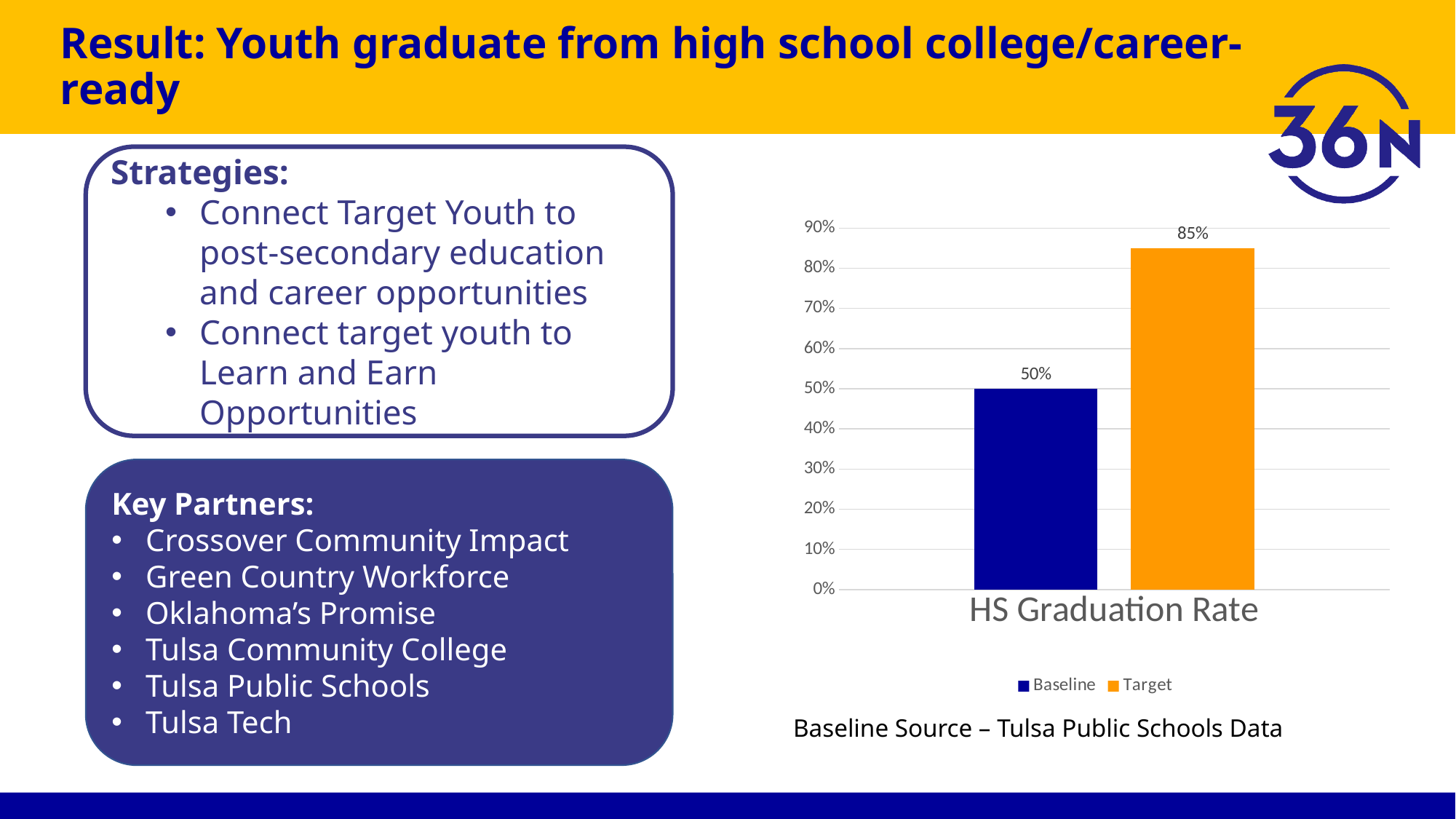
Is the Target value for HS Graduation Rate greater or less than 80%? greater Which series has the higher value for HS Graduation Rate, Baseline or Target? Target Is the Baseline value for HS Graduation Rate greater or less than 60%? less How many series does the legend list? 2 How many categories are shown on the x axis of the chart? 1 What is the Baseline value for HS Graduation Rate? 50% What is the Target value for HS Graduation Rate? 85% What is the highest value shown on the chart's y axis? 90% What is the category label shown on the x axis of the chart? HS Graduation Rate What colour is the Target bar in the chart? Orange What is the difference between the Target and Baseline values for HS Graduation Rate? 35% What kind of chart is shown on the slide? Bar chart